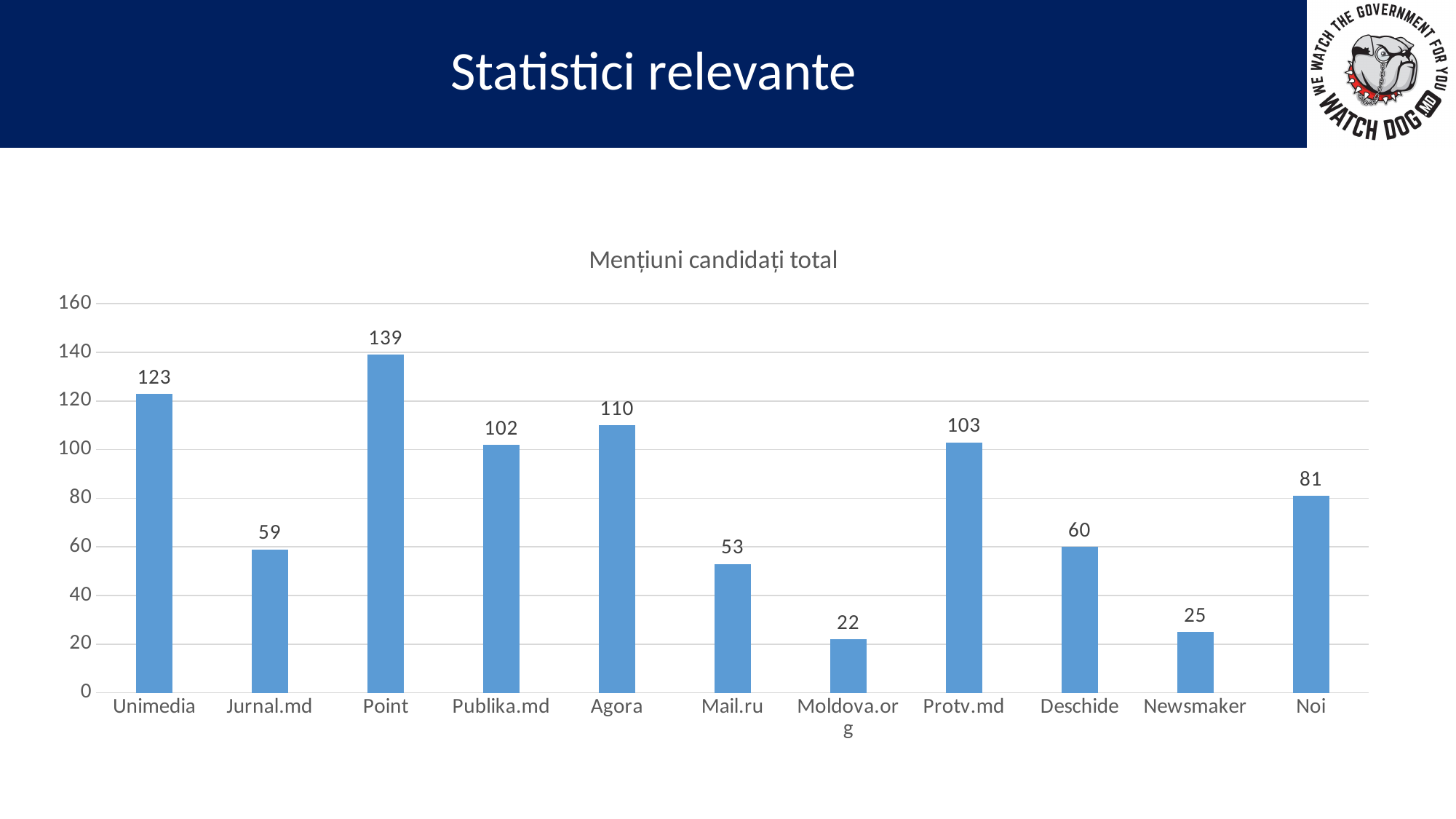
Which category has the lowest value? Moldova.org What is the difference between the values for Point and Unimedia? 16 Is the value for Deschide greater or less than 80? less Which is larger, the value for Publika.md or the value for Noi? Publika.md What is the value for Protv.md? 103 What is the value for Unimedia? 123 What is the value for Newsmaker? 25 How many categories are shown on the x axis? 11 What is the title of the chart? Mențiuni candidați total What kind of chart is shown on the slide? bar chart Which category has the highest value? Point What is the difference between the values for Agora and Mail.ru? 57